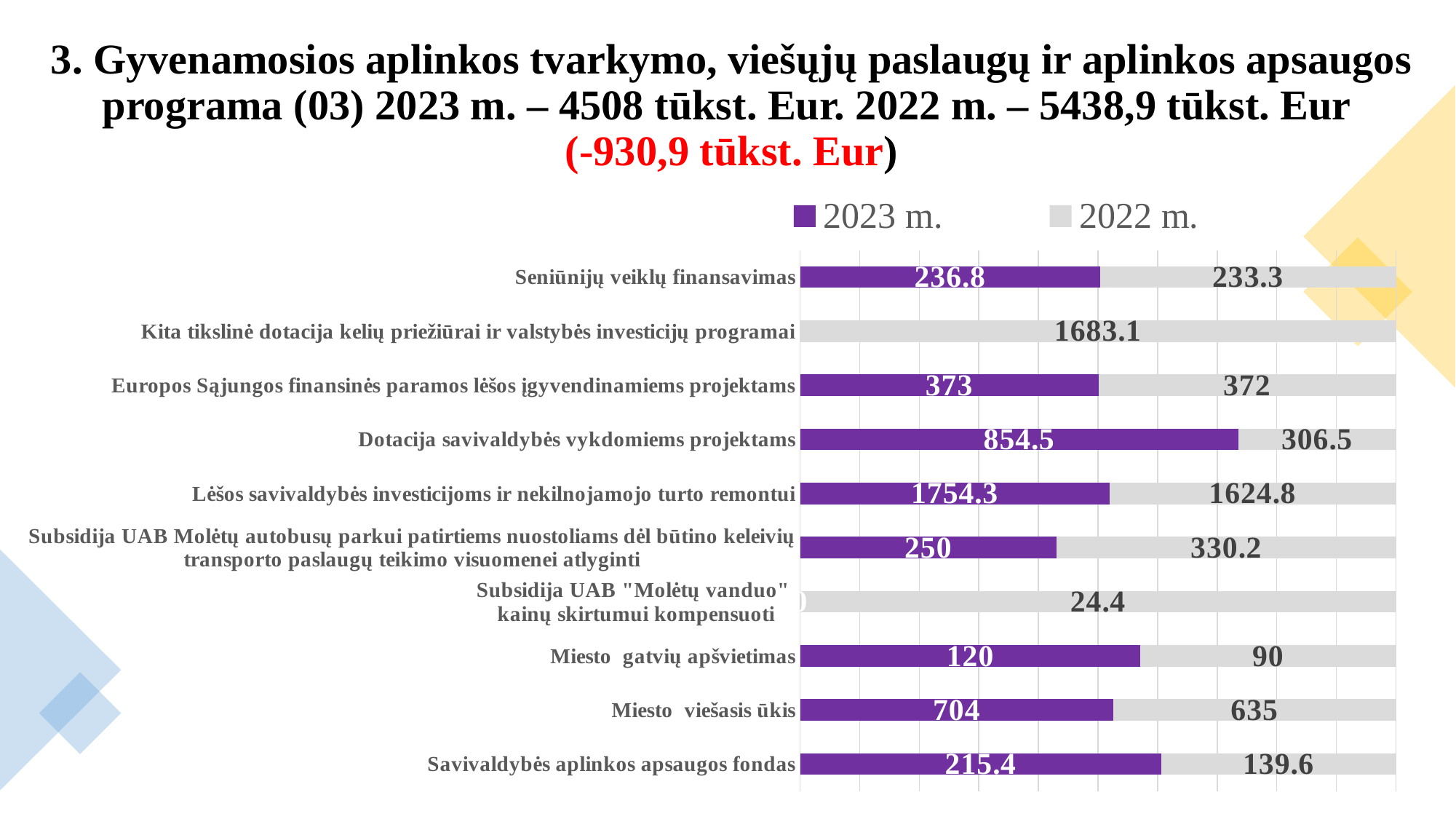
Which category has the lowest 2022 m. value? Subsidija UAB "Molėtų vanduo" kainų skirtumui kompensuoti How many categories are shown in the chart? 10 What kind of chart is shown on the slide? Bar chart What is the 2022 m. value for Savivaldybės aplinkos apsaugos fondas? 139.6 What is the 2023 m. value for Dotacija savivaldybės vykdomiems projektams? 854.5 What is the difference between the 2022 m. and 2023 m. values for Subsidija UAB Molėtų autobusų parkui patirtiems nuostoliams dėl būtino keleivių transporto paslaugų teikimo visuomenei atlyginti? 80.2 What is the 2023 m. value for Miesto gatvių apšvietimas? 120 How many series does the legend list? 2 Which category has the highest 2023 m. value? Lėšos savivaldybės investicijoms ir nekilnojamojo turto remontui What is the difference between the 2023 m. and 2022 m. values for Miesto viešasis ūkis? 69 What is the 2022 m. value for Kita tikslinė dotacija kelių priežiūrai ir valstybės investicijų programai? 1683.1 Which is larger for Dotacija savivaldybės vykdomiems projektams: the 2023 m. value or the 2022 m. value? 2023 m.